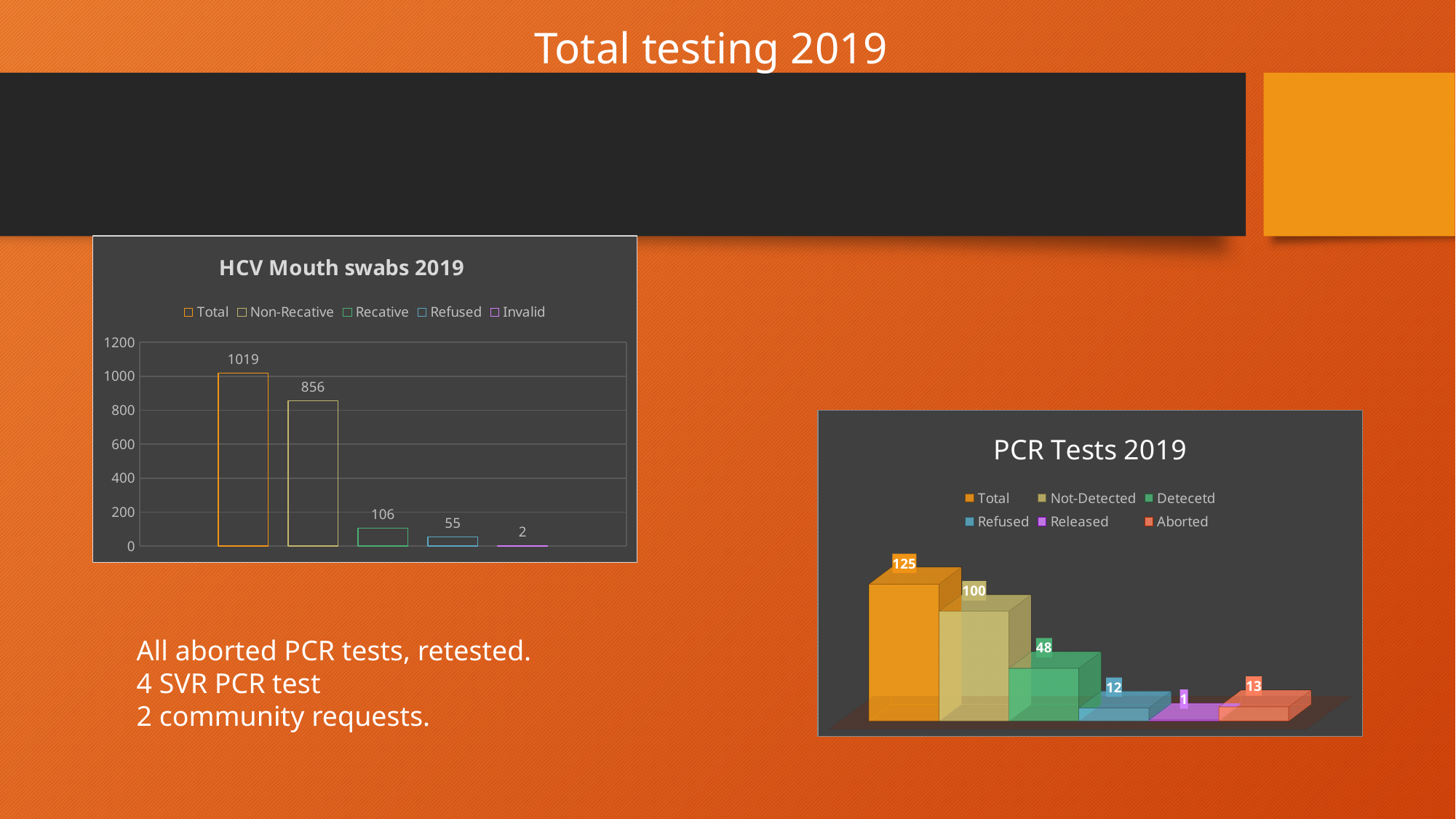
In the HCV Mouth swabs 2019 chart, what is the value for Total? 1019 In the HCV Mouth swabs 2019 chart, which series has the lowest value? Invalid In the PCR Tests 2019 chart, what is the value for Not-Detected? 100 In the PCR Tests 2019 chart, what is the value for Detecetd? 48 In the PCR Tests 2019 chart, which is larger, Refused or Aborted? Aborted What kind of chart is the PCR Tests 2019 chart? bar chart In the HCV Mouth swabs 2019 chart, what is the value for Recative? 106 In the HCV Mouth swabs 2019 chart, what is the value for Non-Recative? 856 In the HCV Mouth swabs 2019 chart, how many series does the legend list? 5 In the HCV Mouth swabs 2019 chart, is the value for Refused greater or less than 200? less In the PCR Tests 2019 chart, what is the difference between Total and Not-Detected? 25 In the HCV Mouth swabs 2019 chart, what is the difference between Non-Recative and Recative? 750